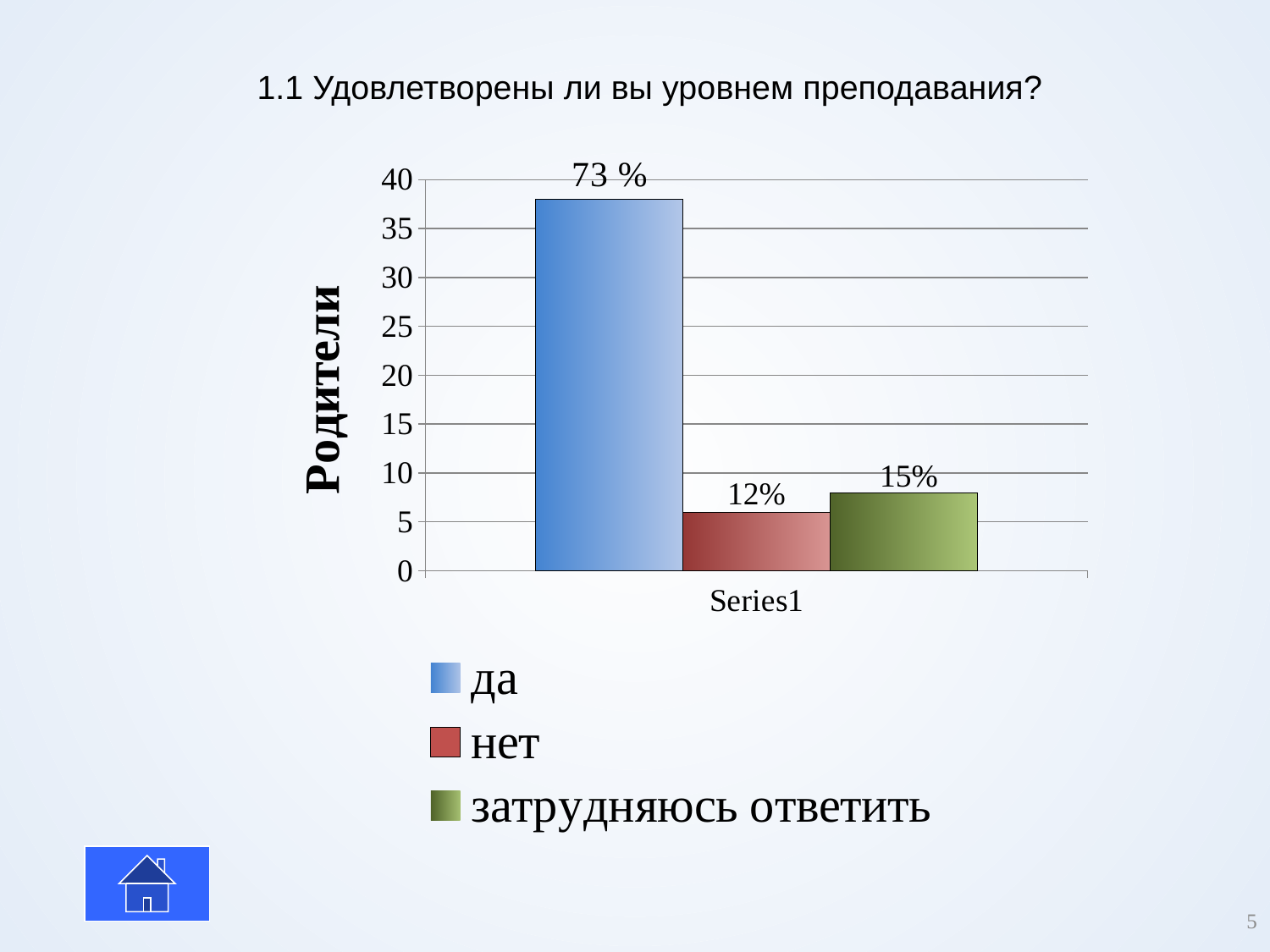
Is the bar for "нет" greater or less than 10 on the vertical axis? less How many bars are plotted in the chart? 3 What data label is shown on the bar for "да"? 73 % What is the title of the vertical axis? Родители What type of chart is shown on the slide? bar chart What data label is shown on the bar for "нет"? 12% Which answer option has the tallest bar? да How many entries does the legend list? 3 What data label is shown on the bar for "затрудняюсь ответить"? 15% Which bar is taller: "нет" or "затрудняюсь ответить"? затрудняюсь ответить Is the bar for "да" greater or less than 35 on the vertical axis? greater Which answer option has the shortest bar? нет